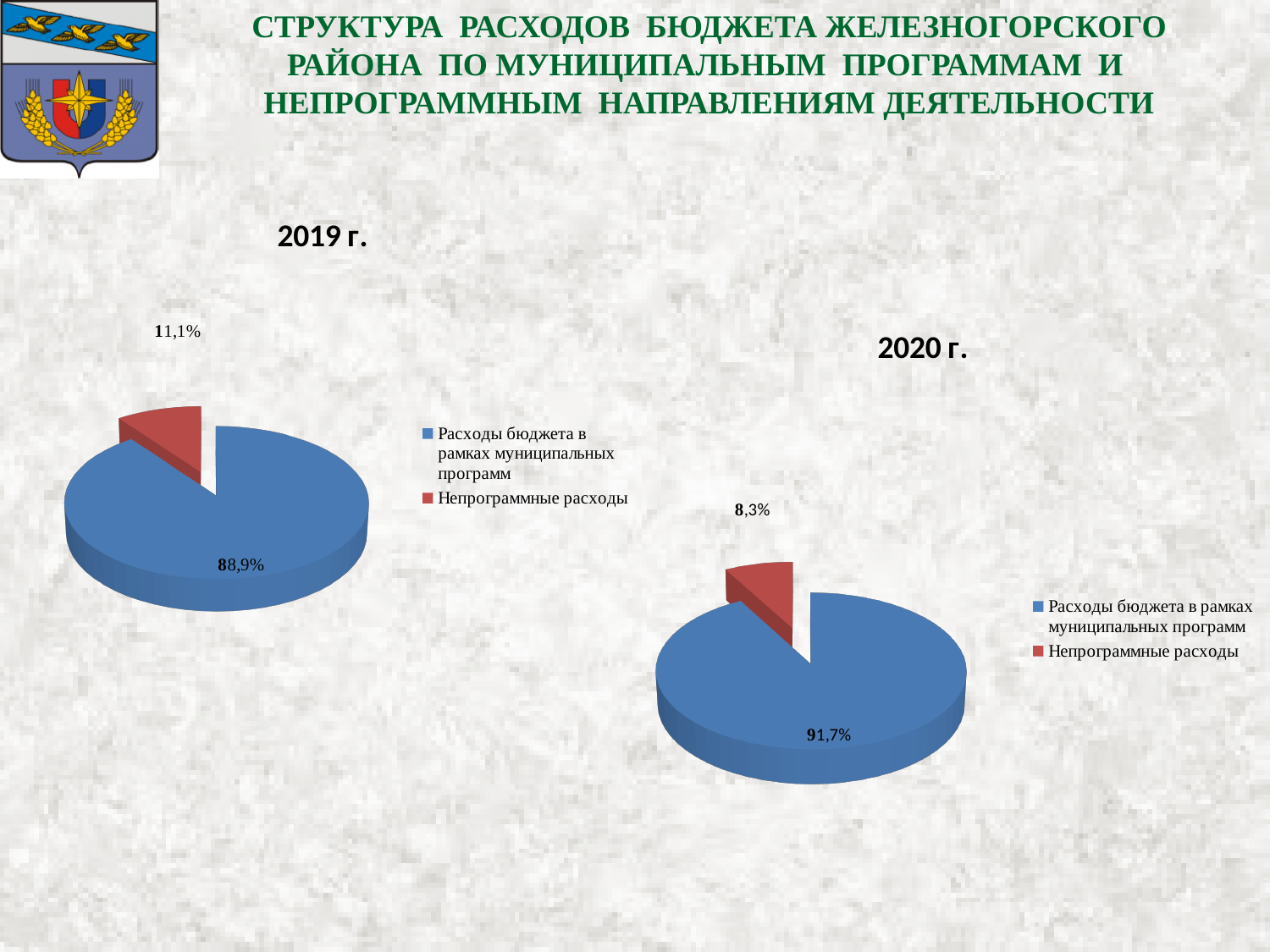
What is the difference between the share of Непрограммные расходы in the 2019 г. chart and in the 2020 г. chart? 2,8% In the 2019 г. chart, which category has the largest slice? Расходы бюджета в рамках муниципальных программ How many slices does the 2020 г. pie chart have? 2 What type of chart is used for 2019 г.? Pie chart In the 2020 г. pie chart, what share is shown for Непрограммные расходы? 8,3% In the 2019 г. pie chart, what share is shown for Непрограммные расходы? 11,1% How many entries does the legend of the 2019 г. chart list? 2 Is the share of Непрограммные расходы larger in the 2019 г. chart or in the 2020 г. chart? 2019 г. In the 2020 г. chart, which category has the smallest slice? Непрограммные расходы In the 2020 г. chart, what colour is the slice for Непрограммные расходы? Red In the 2020 г. pie chart, what share is shown for Расходы бюджета в рамках муниципальных программ? 91,7% In the 2019 г. pie chart, what share is shown for Расходы бюджета в рамках муниципальных программ? 88,9%